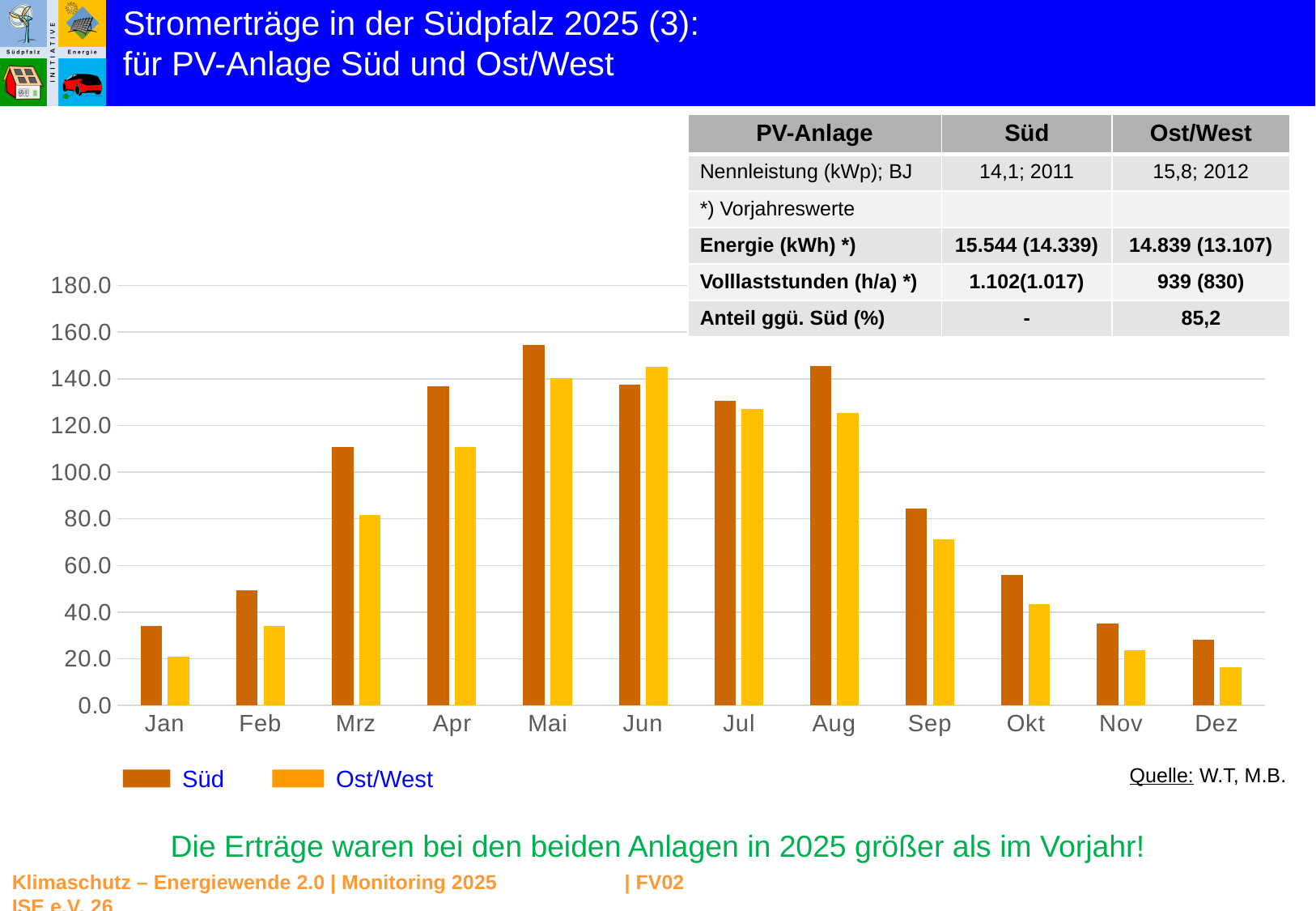
Is the Süd value for Mrz greater or less than 100? greater What kind of chart is shown on the slide? bar chart In Jun, which series has the larger value, Süd or Ost/West? Ost/West Is the Ost/West value for Sep greater or less than 80? less How many months are shown on the x axis of the chart? 12 In which month is the Süd value lowest? Dez In Mai, which series has the larger value, Süd or Ost/West? Süd In which month is the Süd value highest? Mai In which month is the Ost/West value lowest? Dez How many series does the chart legend list? 2 Do the Süd values rise or fall from Aug to Dez? fall In which month is the Ost/West value highest? Jun